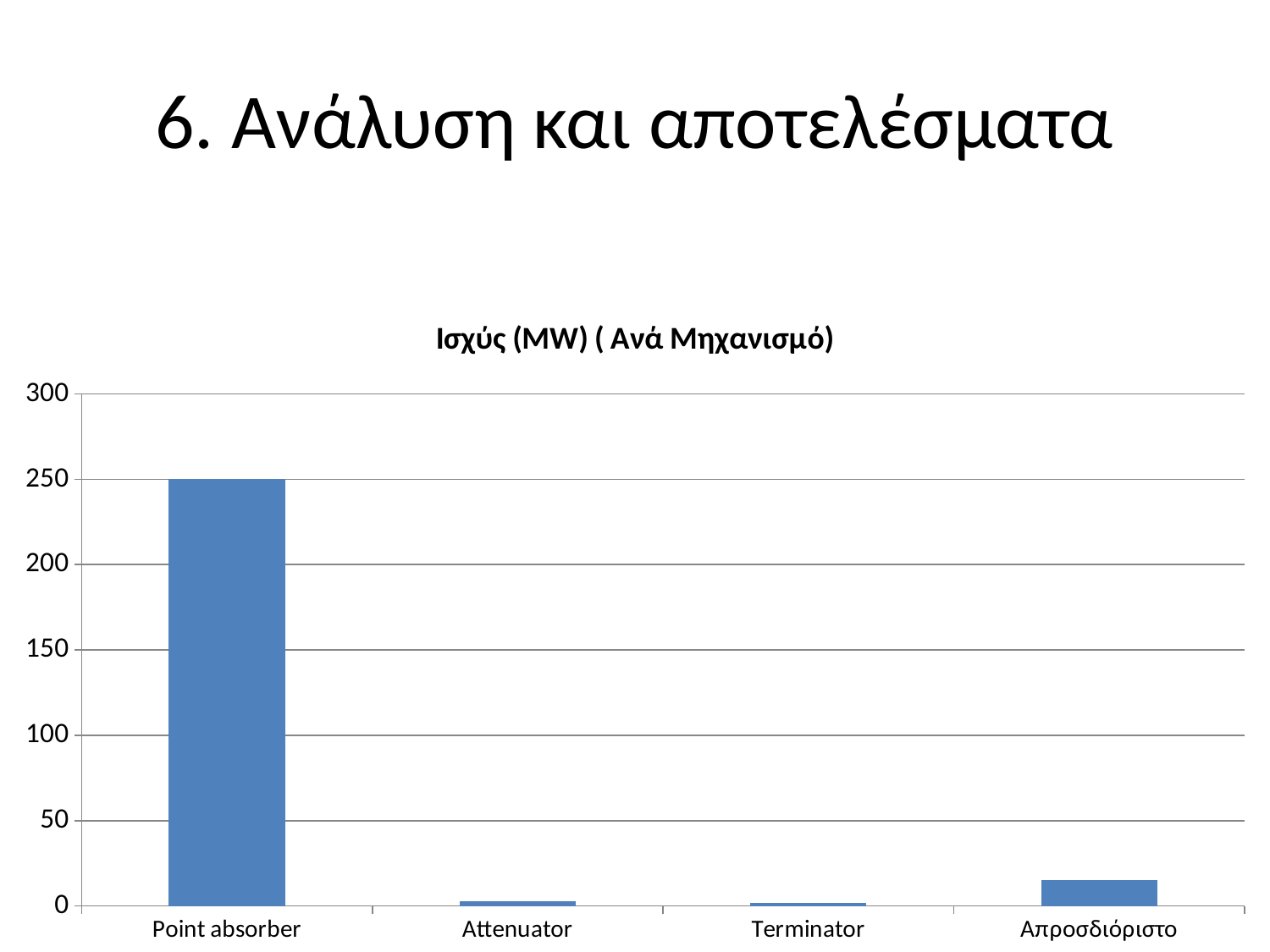
Is the value for Απροσδιόριστο greater or less than 50? less Is the value for Point absorber greater or less than 200? greater Which is larger, the value for Point absorber or the value for Απροσδιόριστο? Point absorber How many categories are shown on the x axis of the chart? 4 What is the highest value shown on the vertical axis of the chart? 300 What type of chart is shown on the slide? bar chart Is the value for Terminator greater or less than 100? less Which category has the highest value in the chart? Point absorber What is the title of the chart? Ισχύς (MW) ( Ανά Μηχανισμό) What is the value for Point absorber? 250 Which is larger, the value for Απροσδιόριστο or the value for Attenuator? Απροσδιόριστο